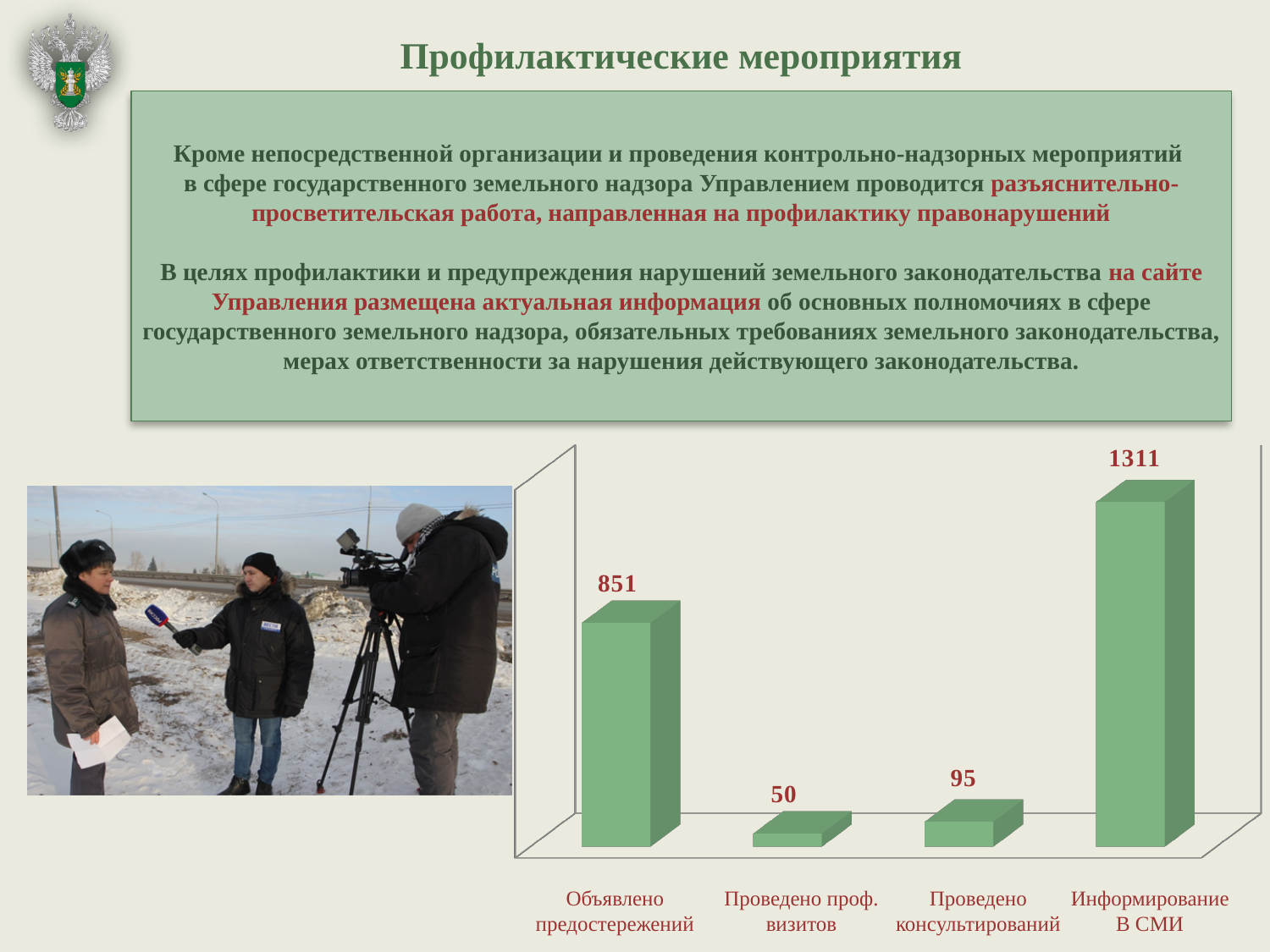
What is the value for "Информирование в СМИ"? 1311 Which category has the highest value? Информирование в СМИ What is the difference between the values for "Проведено консультирований" and "Проведено проф. визитов"? 45 What kind of chart is shown on the slide? bar chart What is the value for "Объявлено предостережений"? 851 How many categories are shown in the chart? 4 What colour are the bars in the chart? green What is the value for "Проведено проф. визитов"? 50 Which category has the lowest value? Проведено проф. визитов What is the difference between the values for "Информирование в СМИ" and "Объявлено предостережений"? 460 What is the value for "Проведено консультирований"? 95 Which is larger: the value for "Объявлено предостережений" or the value for "Проведено консультирований"? Объявлено предостережений